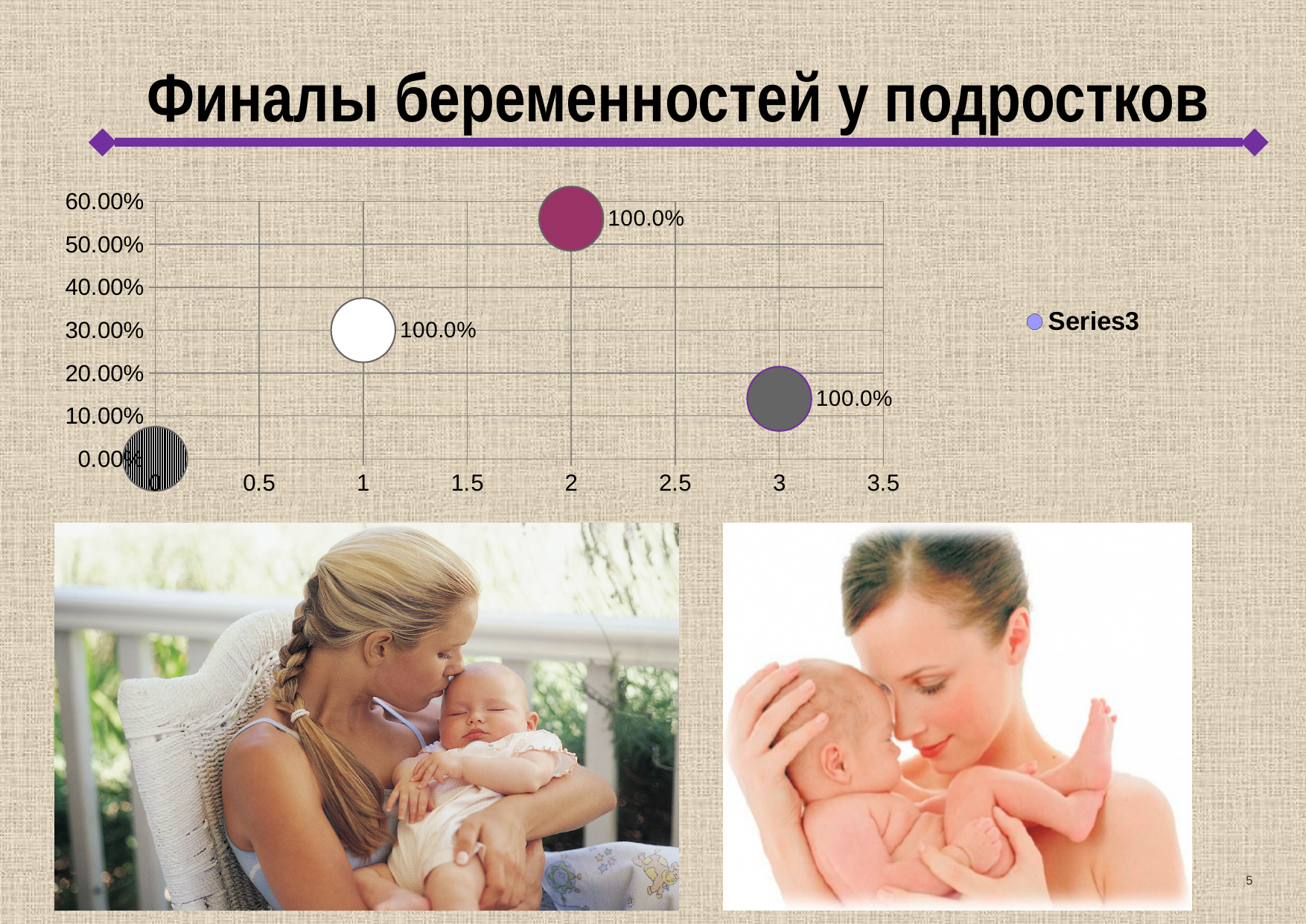
What is the name of the series shown in the chart legend? Series3 How many bubbles are plotted on the chart? 4 At which x position is the bubble with the highest vertical value? 2 At which x position is the bubble with the lowest vertical value? 0 How many series does the chart legend list? 1 What data label is printed next to the bubble at x = 3? 100.0% Which bubble is positioned higher on the vertical axis, the one at x = 1 or the one at x = 3? the one at x = 1 What kind of chart is shown on the slide? bubble chart What is the title of the slide containing the chart? Финалы беременностей у подростков Is the vertical value of the bubble at x = 2 greater or less than 50.00%? greater Is the vertical value of the bubble at x = 3 greater or less than 20.00%? less What data label is printed next to the bubble at x = 2? 100.0%